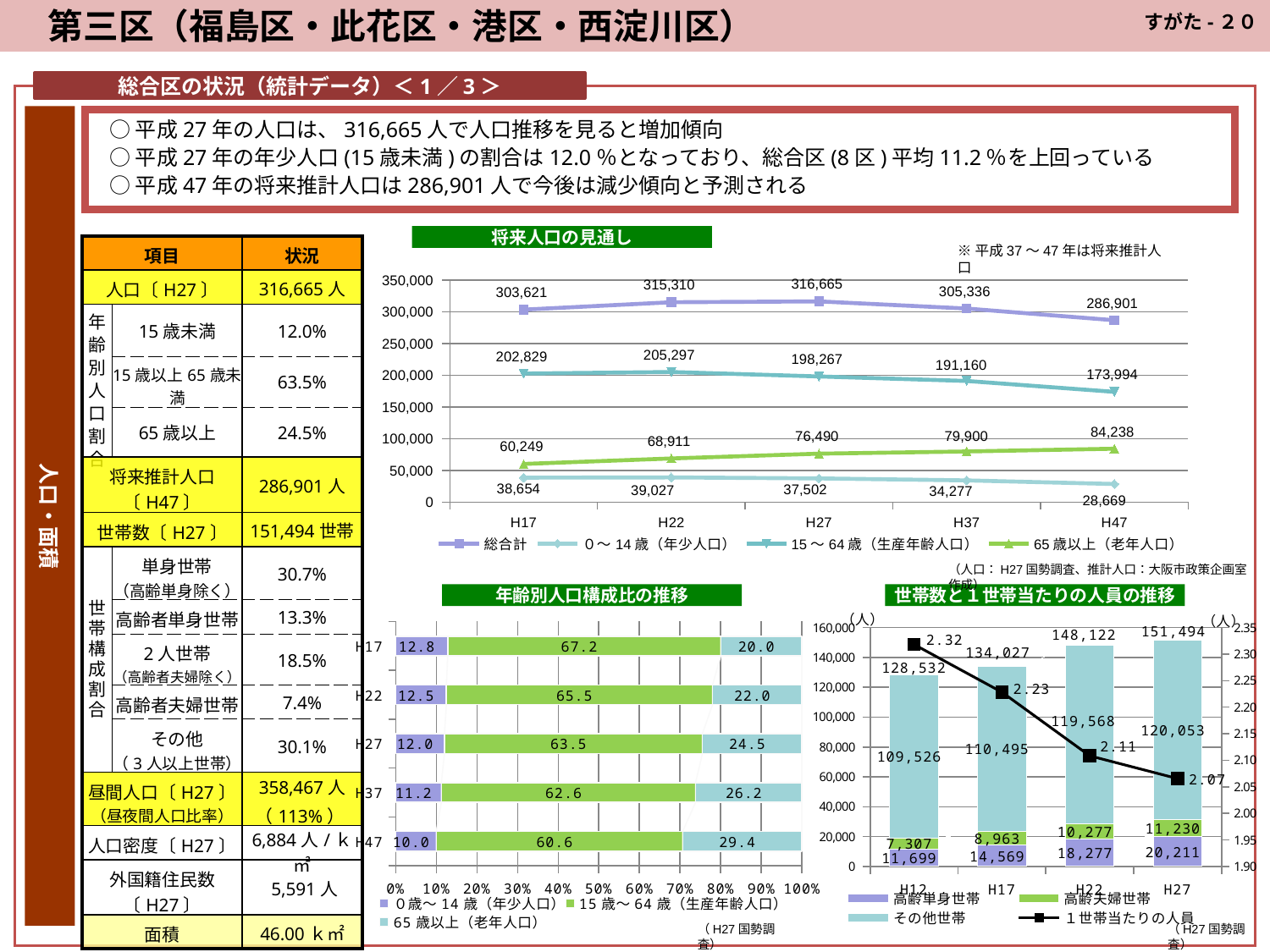
What kind of chart is the 年齢別人口構成比の推移 chart? stacked bar chart In the 年齢別人口構成比の推移 chart, which year has the lowest 0歳～14歳（年少人口） share? H47 In the 年齢別人口構成比の推移 chart, what is the 15歳～64歳（生産年齢人口） share for H37? 62.6 In the 将来人口の見通し chart, what is the 総合計 value for H27? 316,665 In the 世帯数と1世帯当たりの人員の推移 chart, which is larger, the 高齢単身世帯 value for H22 or the 高齢夫婦世帯 value for H22? 高齢単身世帯 In the 将来人口の見通し chart, what is the 65歳以上（老年人口） value for H47? 84,238 In the 世帯数と1世帯当たりの人員の推移 chart, what is the total number of households for H27? 151,494 In the 世帯数と1世帯当たりの人員の推移 chart, what is the 1世帯当たりの人員 value for H12? 2.32 In the 将来人口の見通し chart, what is the difference between the 総合計 values for H27 and H47? 29,764 In the 将来人口の見通し chart, how many series does the legend list? 4 In the 将来人口の見通し chart, does the 0～14歳（年少人口） series rise or fall from H22 to H47? fall In the 将来人口の見通し chart, which year has the highest 総合計 value? H27